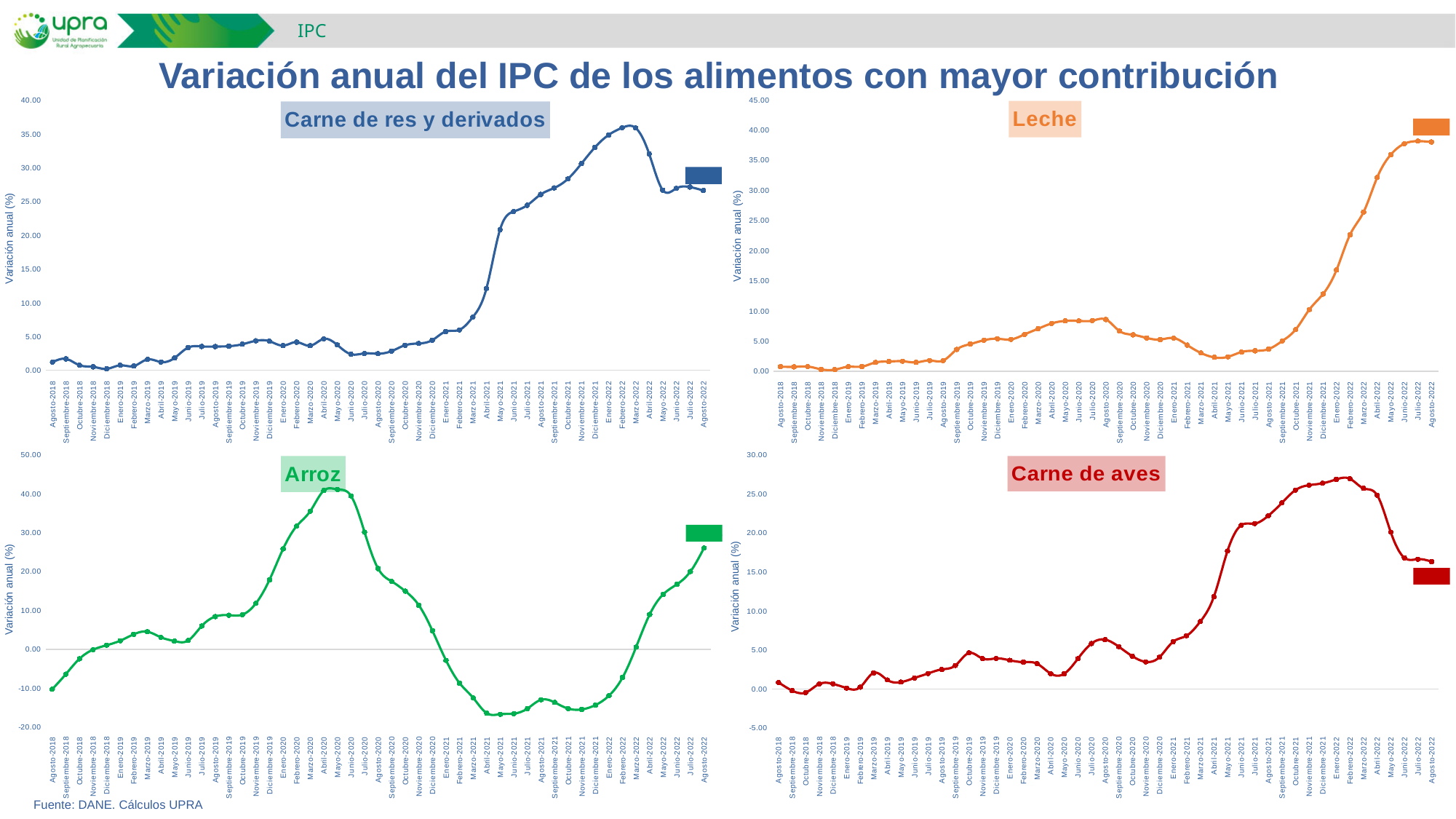
In the 'Carne de aves' chart, is the value for Agosto-2022 greater or less than 20.00? less In the 'Arroz' chart, is the value for Agosto-2018 greater or less than 0.00? less In the 'Leche' chart, do the values rise or fall from Agosto-2021 to Agosto-2022? rise In the 'Carne de res y derivados' chart, is the value for Agosto-2022 greater or less than 20.00? greater In the 'Carne de res y derivados' chart, do the values rise or fall from Febrero-2022 to Agosto-2022? fall How many charts are shown on the slide? 4 What is the source cited at the bottom of the slide? Fuente: DANE. Cálculos UPRA What kind of chart is used for 'Carne de res y derivados'? Line chart